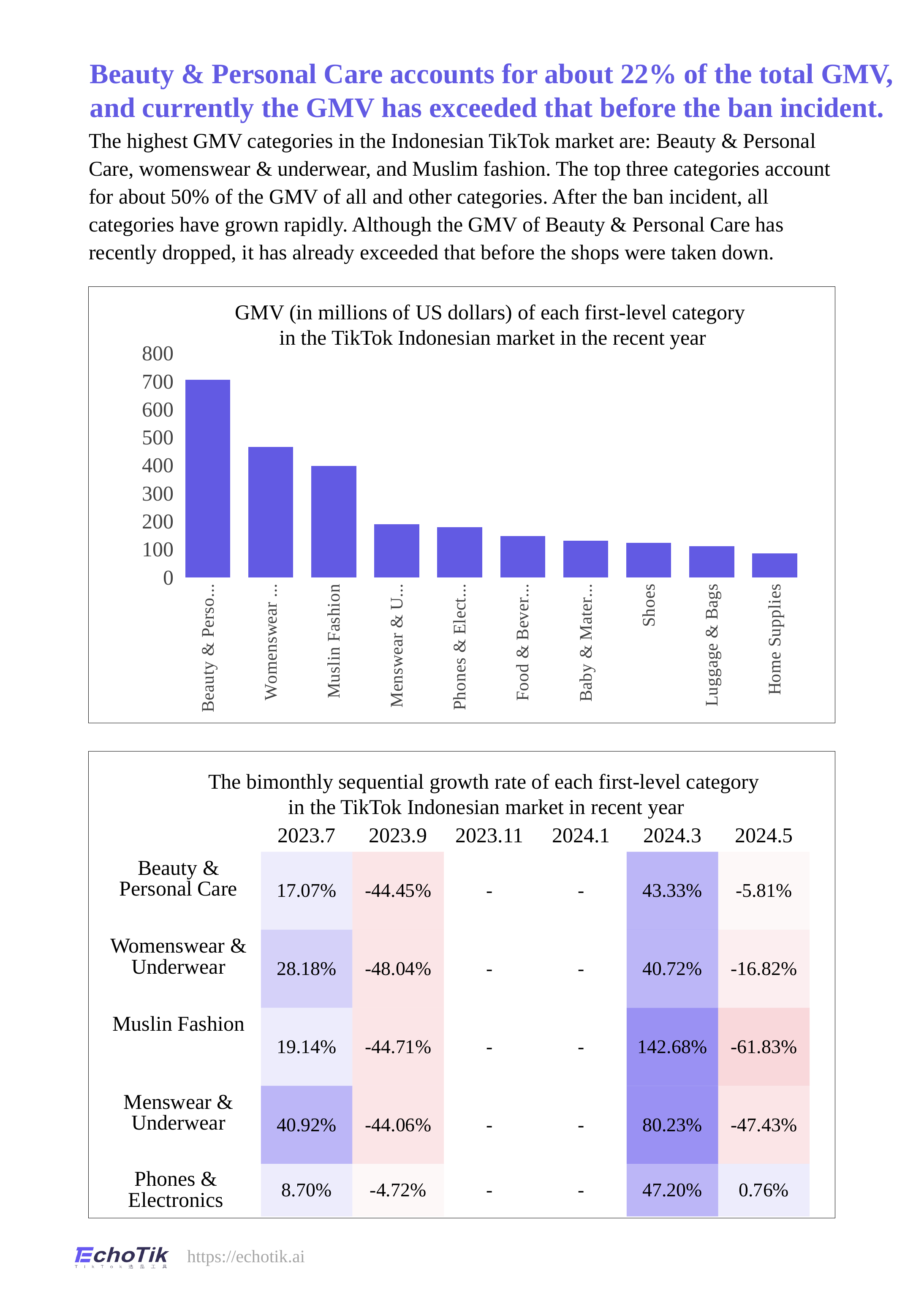
In the GMV bar chart, which category has the highest GMV? Beauty & Personal Care In the GMV bar chart, do the values rise or fall from left to right? fall In the GMV bar chart, is the value for Muslin Fashion greater or less than 500? less In the GMV bar chart, is the value for Womenswear greater or less than 400? greater In the bimonthly growth rate table, what is the growth rate for Muslin Fashion in 2024.3? 142.68% What kind of chart is the GMV chart at the top of the slide? bar chart In the bimonthly growth rate table, which category has the highest growth rate in 2024.3? Muslin Fashion In the GMV bar chart, is the value for Beauty & Personal Care greater or less than 600? greater In the GMV bar chart, which is larger, Muslin Fashion or Menswear? Muslin Fashion How many categories are shown in the GMV bar chart? 10 In the GMV bar chart, which category has the lowest GMV? Home Supplies